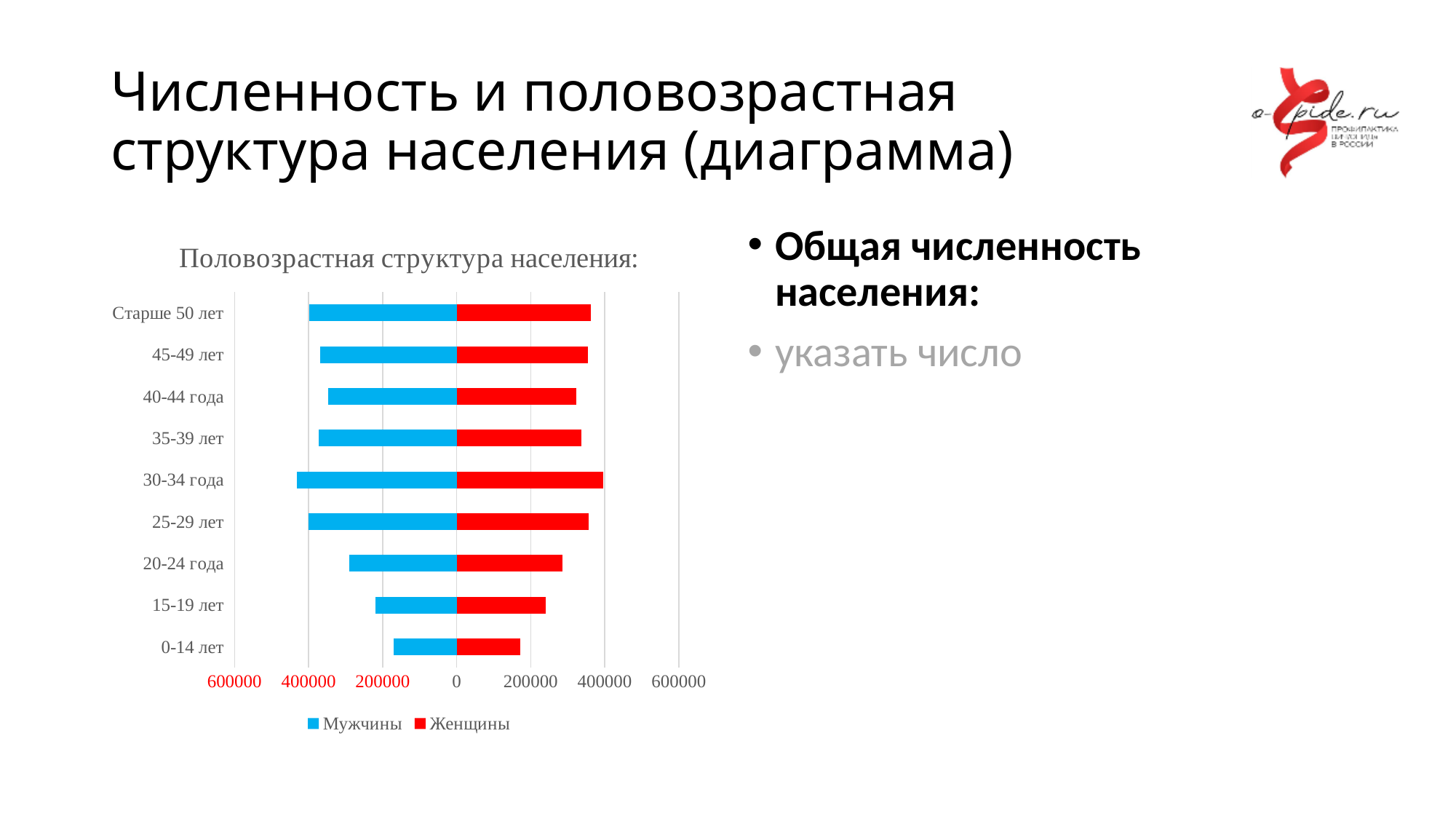
Which age group has the highest value for Женщины? 30-34 года How many series does the chart legend list? 2 How many age groups are shown on the chart? 9 Is the value for Женщины in the 20-24 года group greater or less than 200000? greater Is the value for Мужчины in the 0-14 лет group greater or less than 200000? less What kind of chart is shown on the slide? bar chart What is the title of the chart? Половозрастная структура населения: Is the value for Мужчины in the 30-34 года group greater or less than 400000? greater What are the two series named in the chart legend? Мужчины and Женщины Which is larger for Женщины: the 0-14 лет group or the 25-29 лет group? 25-29 лет Which age group has the highest value for Мужчины? 30-34 года Which age group has the lowest value for Мужчины? 0-14 лет